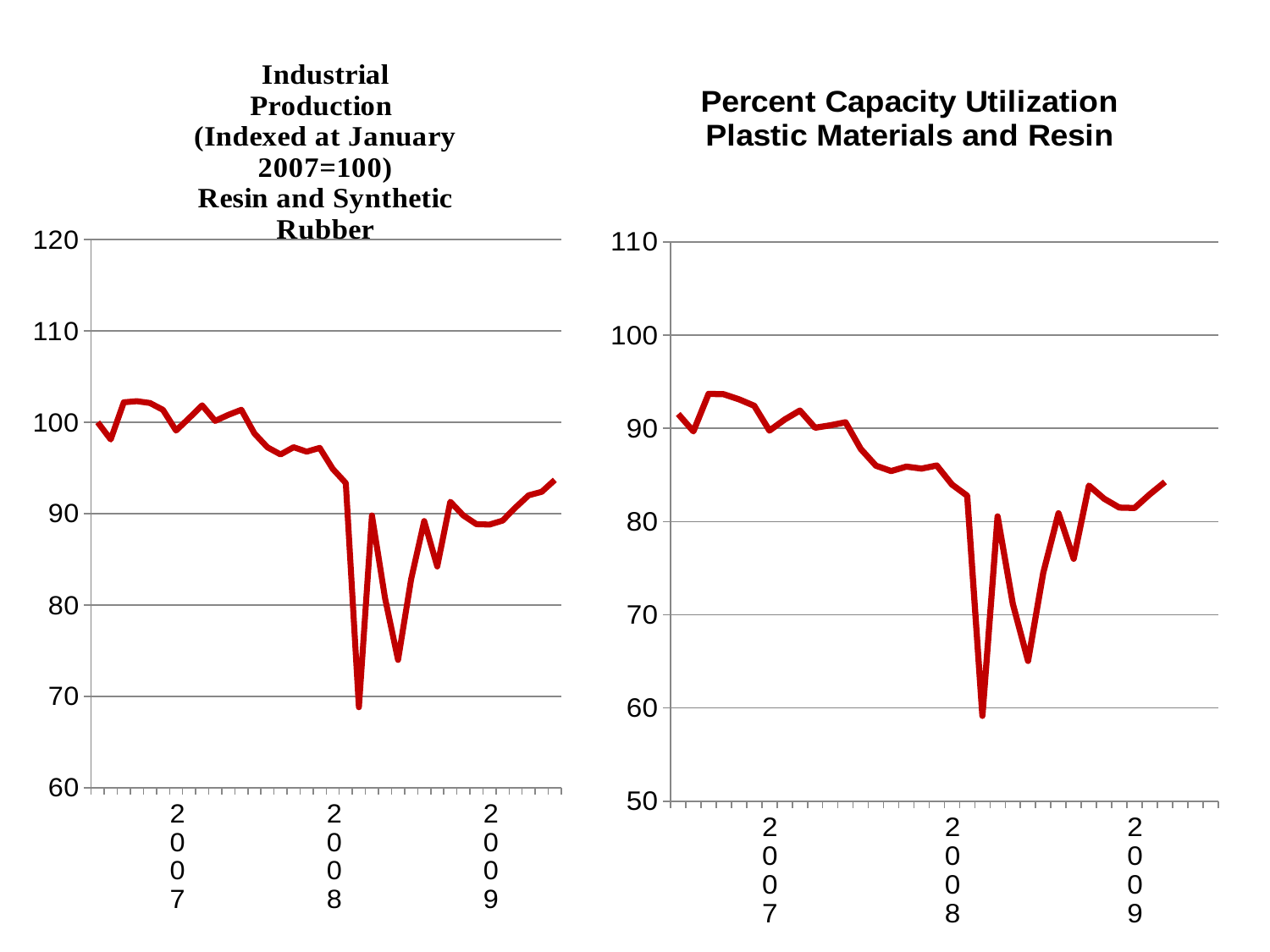
How many charts are shown on the slide? 2 Which years are labelled on the x axis of the right chart (Percent Capacity Utilization)? 2007, 2008, 2009 In the right chart (Percent Capacity Utilization), is the lowest point of the line greater or less than 70? less In the left chart (Industrial Production), what is the index value at January 2007? 100 In the right chart (Percent Capacity Utilization), how many lines are plotted? 1 What kind of chart is the left chart, titled 'Industrial Production (Indexed at January 2007=100) Resin and Synthetic Rubber'? line chart What kind of chart is the right chart, titled 'Percent Capacity Utilization Plastic Materials and Resin'? line chart In the left chart (Industrial Production), do the values overall rise or fall from 2007 to 2009? fall In the left chart (Industrial Production), is the lowest point of the line greater or less than 70? less In the right chart (Percent Capacity Utilization), do the values overall rise or fall from 2007 to 2009? fall In the left chart (Industrial Production), how many lines are plotted? 1